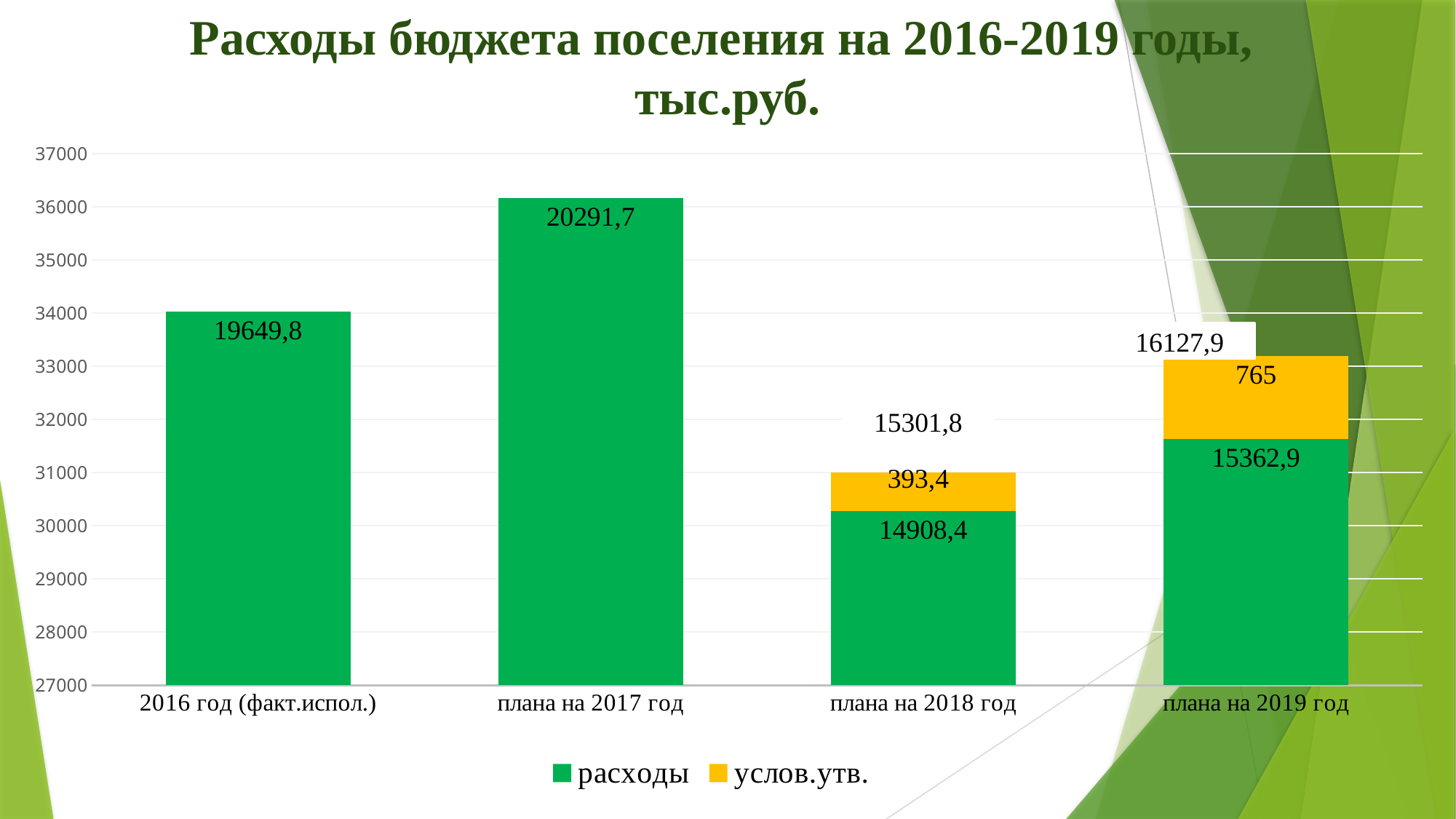
How many series does the legend list? 2 What is the value of услов.утв. for плана на 2019 год? 765 What is the value of расходы for плана на 2019 год? 15362,9 What is the total of the stacked bar for плана на 2019 год? 16127,9 What is the value of расходы for 2016 год (факт.испол.)? 19649,8 What is the value of услов.утв. for плана на 2018 год? 393,4 What kind of chart is shown on the slide? Stacked bar chart What is the value of расходы for плана на 2017 год? 20291,7 Which category has the highest value for расходы? плана на 2017 год What is the total of the stacked bar for плана на 2018 год? 15301,8 Which category has the lowest value for расходы? плана на 2018 год What is the difference between the расходы values for плана на 2017 год and 2016 год (факт.испол.)? 641,9